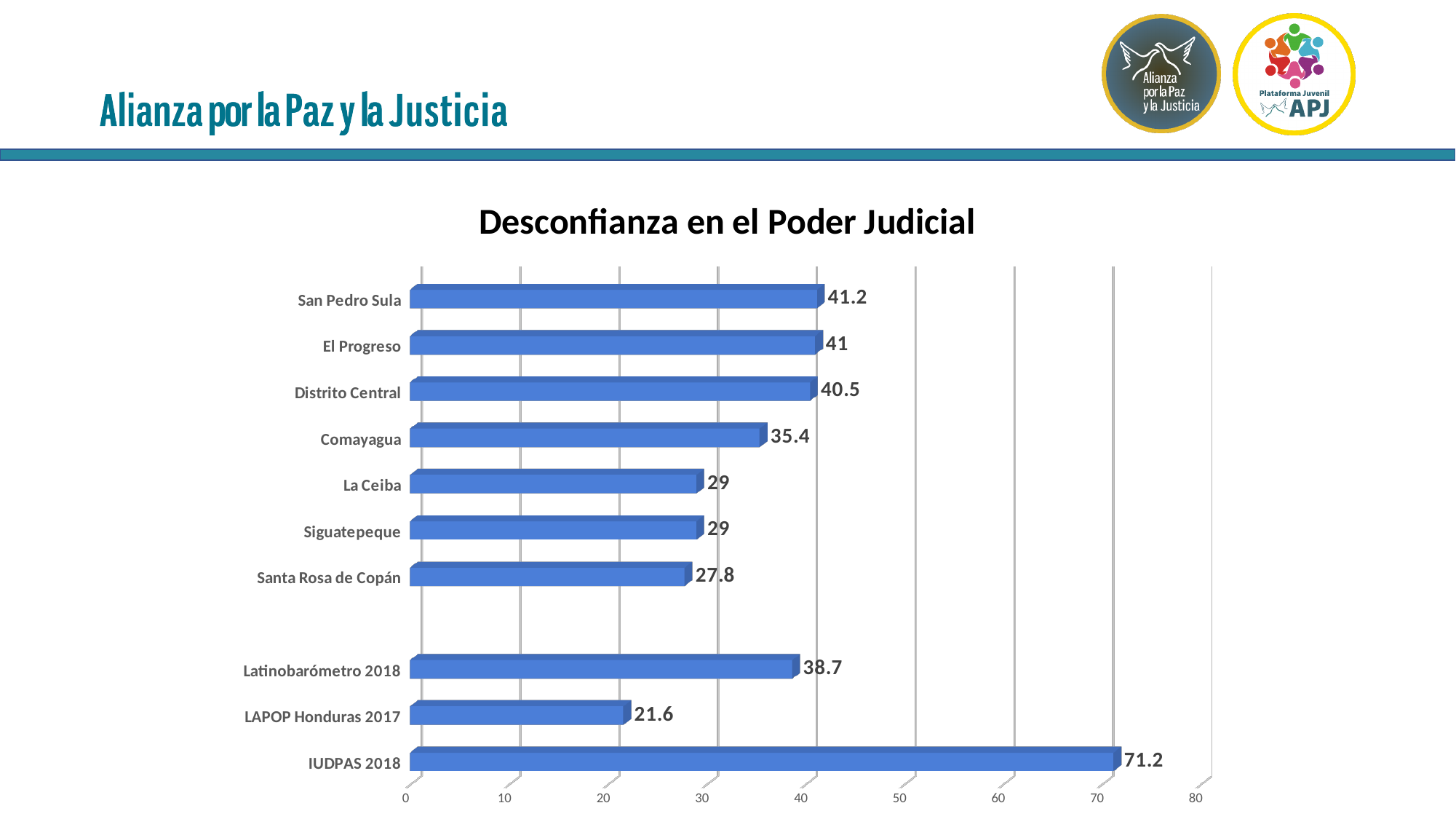
Which is larger, the value for Comayagua or the value for Siguatepeque? Comayagua What is the value for Santa Rosa de Copán? 27.8 What is the value for Comayagua? 35.4 How many categories are shown in the chart? 10 What is the difference between the values for Distrito Central and La Ceiba? 11.5 What is the value for LAPOP Honduras 2017? 21.6 What kind of chart is this? Bar chart What is the difference between the values for IUDPAS 2018 and Latinobarómetro 2018? 32.5 Which category has the lowest value? LAPOP Honduras 2017 What is the title of the chart? Desconfianza en el Poder Judicial Which category has the highest value? IUDPAS 2018 What is the value for San Pedro Sula? 41.2